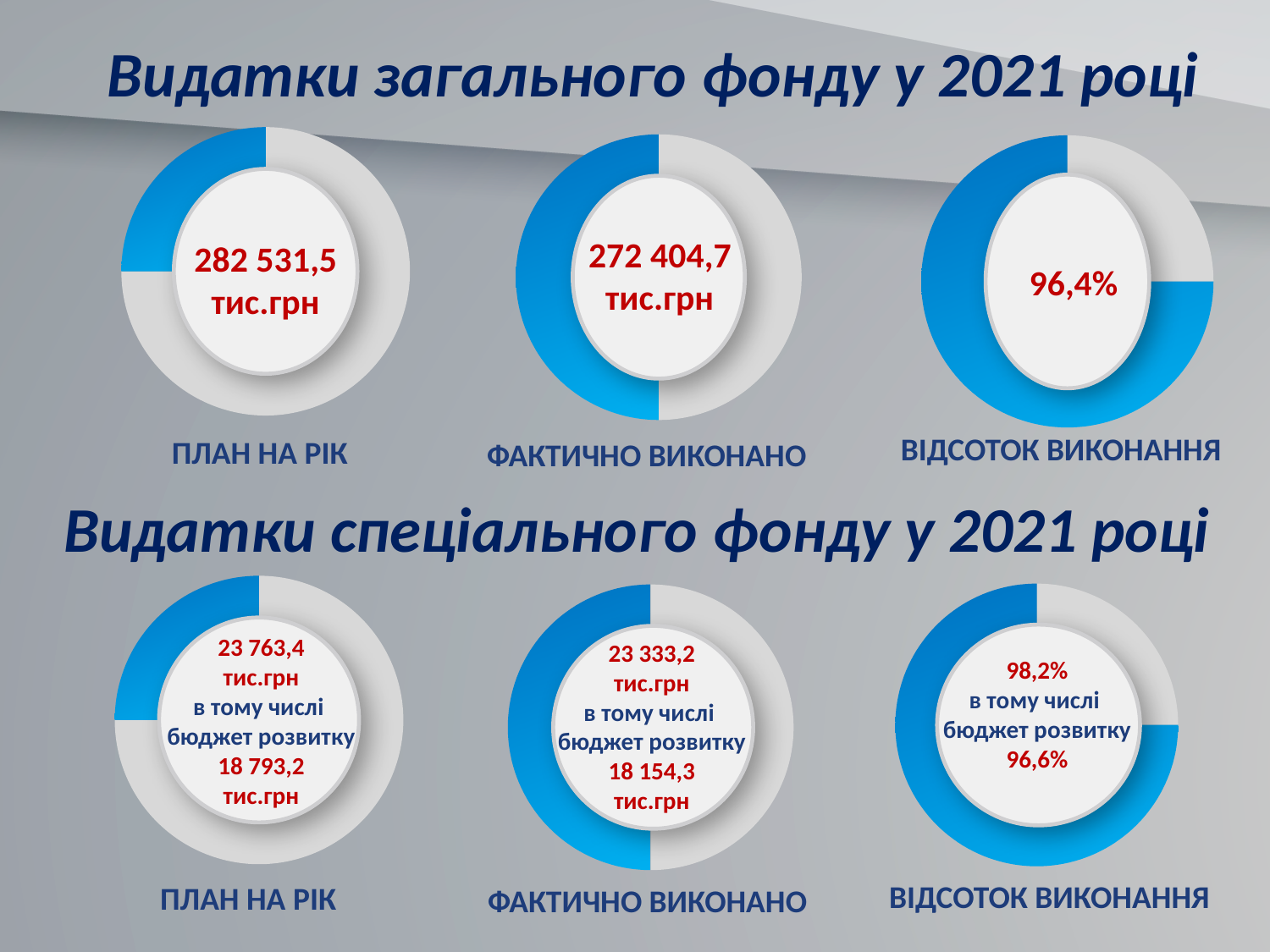
On the 'Видатки загального фонду у 2021 році' section, what percentage is shown in the 'ВІДСОТОК ВИКОНАННЯ' chart? 96,4% On the 'Видатки загального фонду у 2021 році' section, what value is shown in the 'ПЛАН НА РІК' chart? 282 531,5 тис.грн On the 'Видатки загального фонду у 2021 році' section, what is the difference between the 'ПЛАН НА РІК' value and the 'ФАКТИЧНО ВИКОНАНО' value? 10 126,8 тис.грн On the 'Видатки спеціального фонду у 2021 році' section, what is the difference between the total 'ПЛАН НА РІК' value and the total 'ФАКТИЧНО ВИКОНАНО' value? 430,2 тис.грн On the 'Видатки спеціального фонду у 2021 році' section, what is the 'бюджет розвитку' value in the 'ФАКТИЧНО ВИКОНАНО' chart? 18 154,3 тис.грн On the 'Видатки спеціального фонду у 2021 році' section, what is the 'бюджет розвитку' percentage in the 'ВІДСОТОК ВИКОНАННЯ' chart? 96,6% What kind of chart is used for the 'ВІДСОТОК ВИКОНАННЯ' figures on the slide? Donut (pie) chart On the 'Видатки спеціального фонду у 2021 році' section, which is larger: the 'бюджет розвитку' value in 'ПЛАН НА РІК' or in 'ФАКТИЧНО ВИКОНАНО'? ПЛАН НА РІК (18 793,2 тис.грн) How many donut charts are shown on the slide in total? 6 On the 'Видатки загального фонду у 2021 році' section, what value is shown in the 'ФАКТИЧНО ВИКОНАНО' chart? 272 404,7 тис.грн Which is larger: the 'ВІДСОТОК ВИКОНАННЯ' for the загальний фонд or for the спеціальний фонд? спеціальний фонд (98,2%) On the 'Видатки спеціального фонду у 2021 році' section, what is the total value shown in the 'ПЛАН НА РІК' chart? 23 763,4 тис.грн